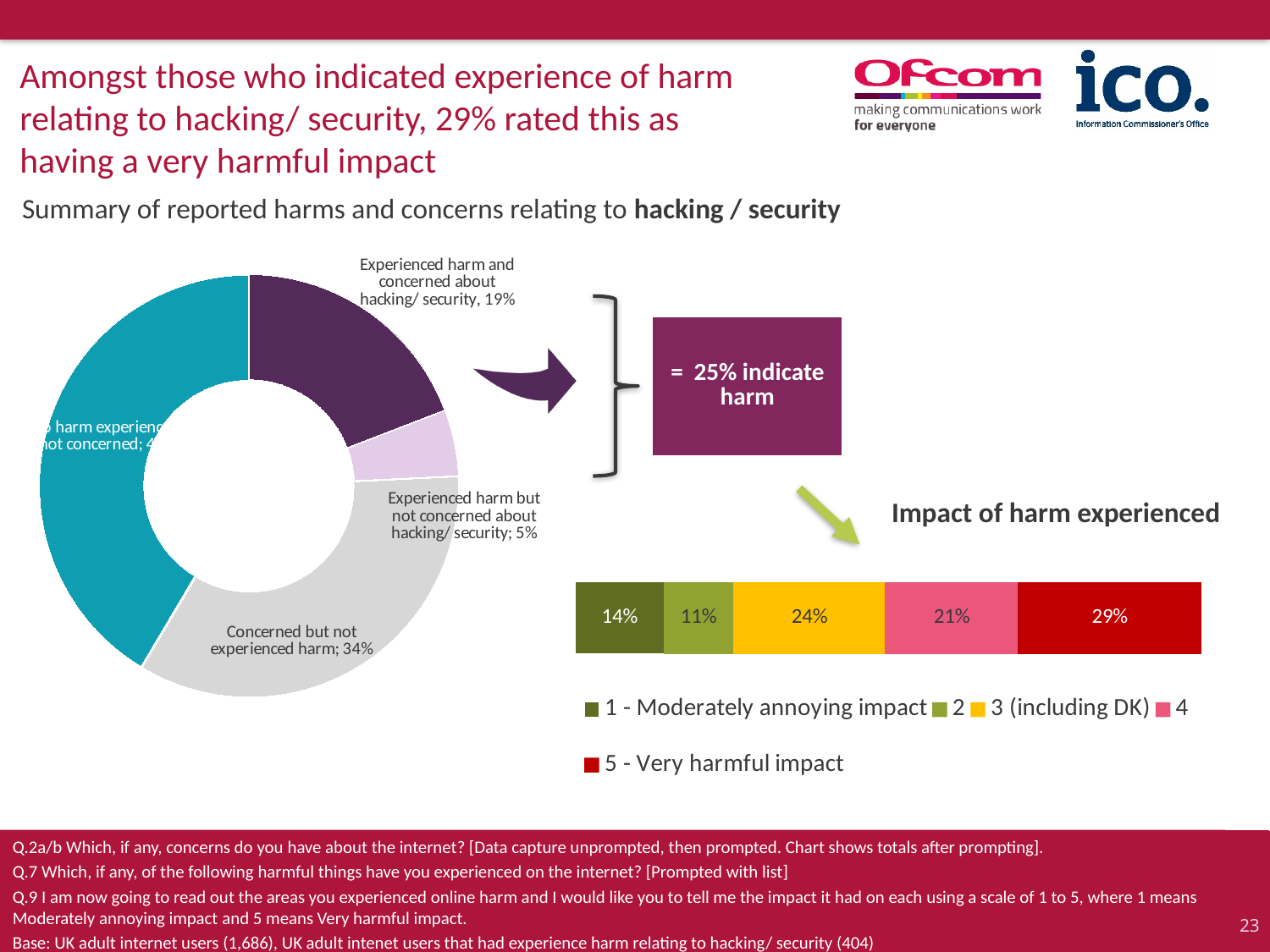
In the 'Impact of harm experienced' chart, what is the difference between the '5 - Very harmful impact' and '1 - Moderately annoying impact' values? 15 percentage points In the donut chart, which is the smallest labelled segment? Experienced harm but not concerned about hacking/ security What type of chart is the chart on the left of the slide? Donut (pie) chart In the donut chart, what percentage are concerned but have not experienced harm? 34% In the 'Impact of harm experienced' chart, what percentage rated the impact as 1 - Moderately annoying impact? 14% In the donut chart, what percentage experienced harm but are not concerned about hacking/ security? 5% In the 'Impact of harm experienced' chart, what percentage rated the impact as 5 - Very harmful impact? 29% How many series does the legend of the 'Impact of harm experienced' chart list? 5 In the donut chart, what is the difference between 'Concerned but not experienced harm' and 'Experienced harm and concerned about hacking/ security'? 15 percentage points In the donut chart, what percentage experienced harm and are concerned about hacking/ security? 19% In the 'Impact of harm experienced' chart, which rating has the highest percentage? 5 - Very harmful impact In the 'Impact of harm experienced' chart, which rating has the lowest percentage? 2